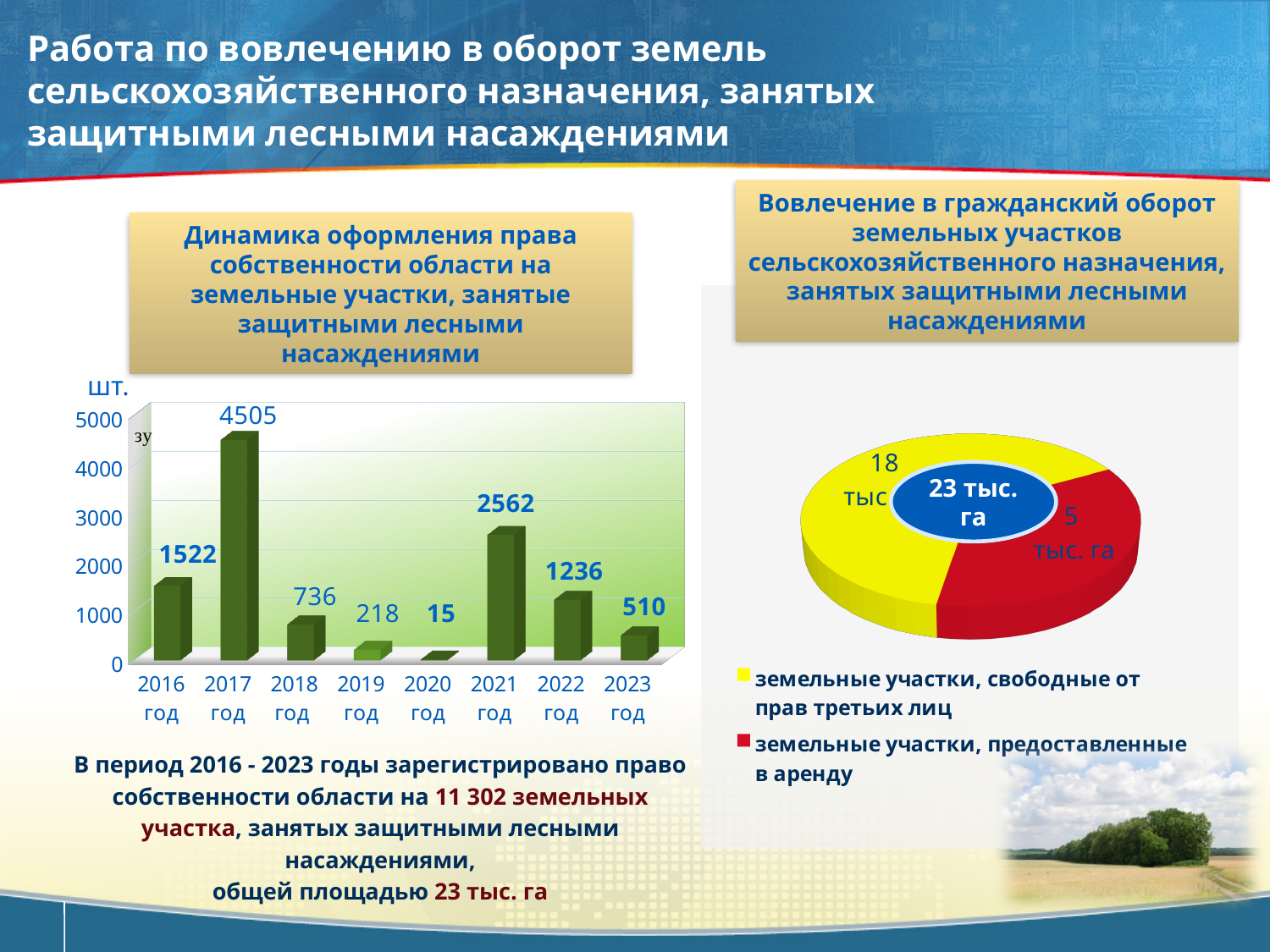
How many years are shown on the bar chart on the left? 8 On the bar chart on the left, what is the difference between the values for 2021 год and 2022 год? 1326 How many entries does the legend of the pie chart on the right list? 2 On the bar chart on the left, is the value for 2018 год greater or less than 1000? less On the bar chart on the left, which year has the lowest value? 2020 год On the bar chart on the left, what is the value for 2020 год? 15 On the bar chart on the left, which is larger: the value for 2016 год or for 2023 год? 2016 год On the pie chart on the right, what is the total area shown in the centre of the pie? 23 тыс. га What kind of chart is the chart on the left of the slide? bar chart On the pie chart on the right, what is the value for земельные участки, свободные от прав третьих лиц? 18 тыс On the bar chart on the left, which year has the highest value? 2017 год On the bar chart on the left, what is the value for 2017 год? 4505